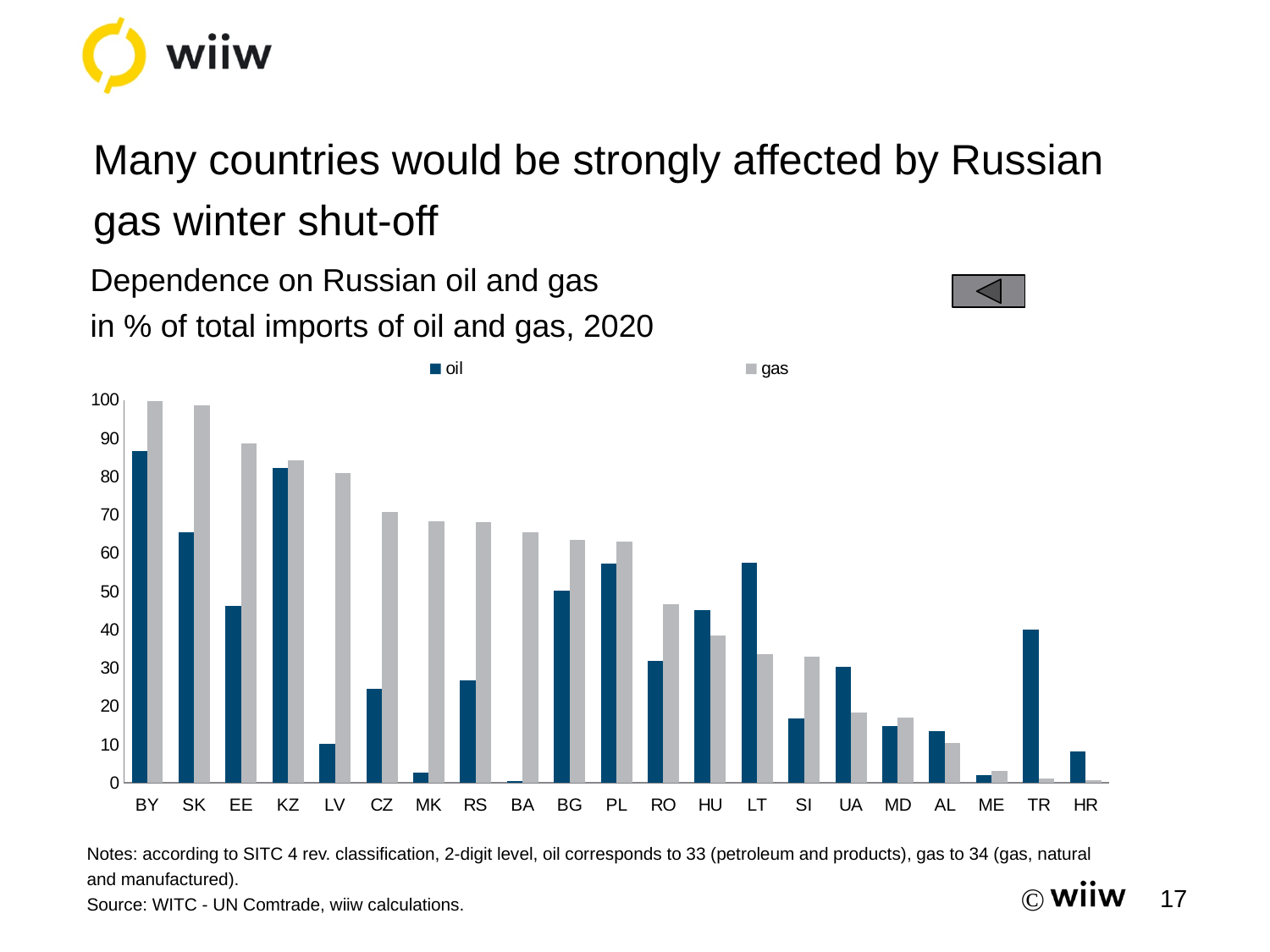
Is the gas value for BY greater or less than 90? greater Is the oil value for LV greater or less than 20? less How many countries are shown on the x axis? 21 For LT, which is larger, the oil value or the gas value? oil What kind of chart is shown on the slide? bar chart For RO, which is larger, the oil value or the gas value? gas How many series does the legend list? 2 Is the oil value for TR greater or less than 30? greater Which country has the highest gas value? BY Which country has the lowest oil value? BA Which country has the highest oil value? BY